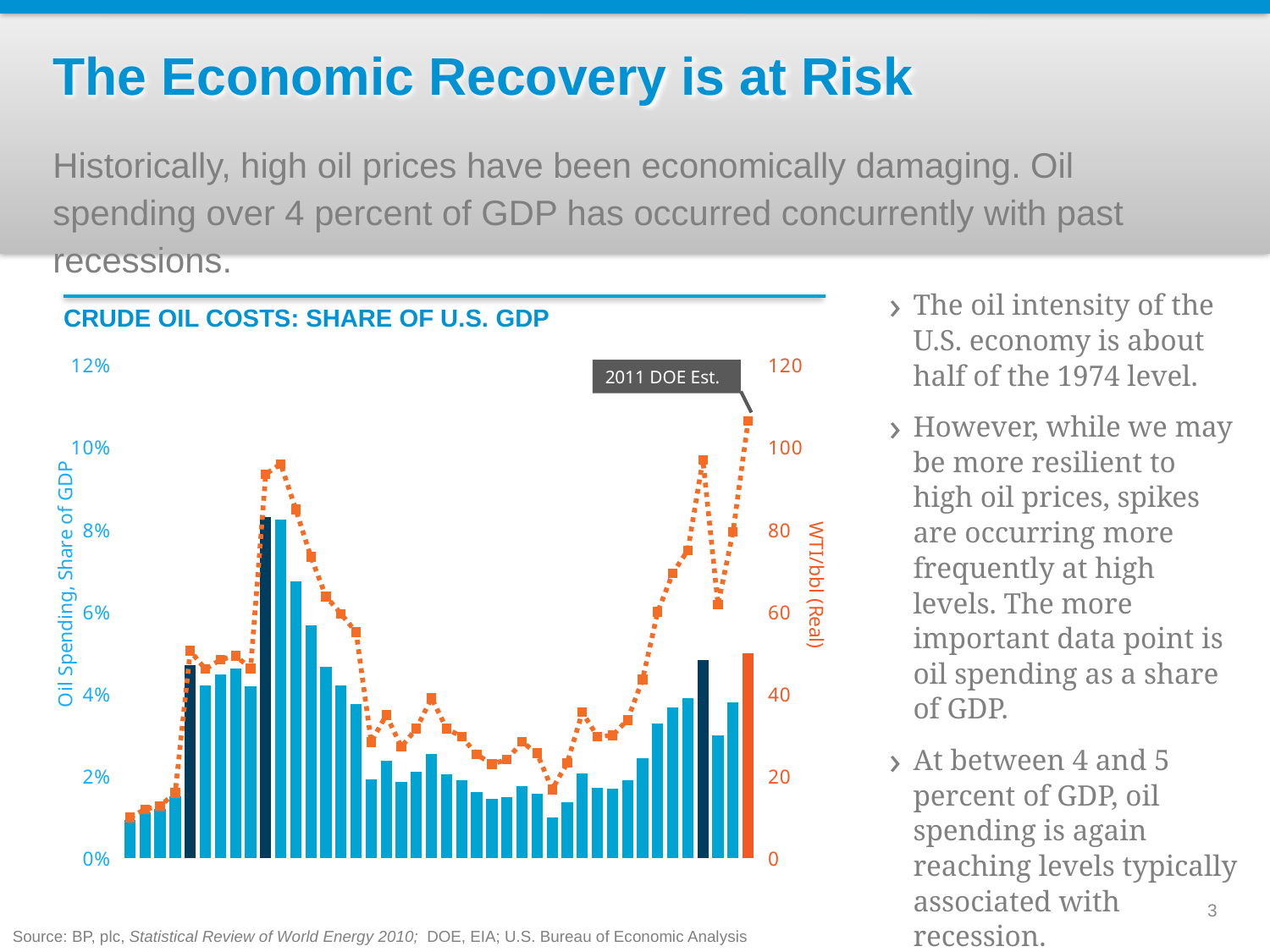
What text does the callout box near the end of the orange line say? 2011 DOE Est. What kind of chart is used to show oil spending as a share of GDP? Bar chart What is the highest value shown on the right axis of the chart? 120 What label is shown on the right vertical axis of the chart? WTI/bbl (Real) Is the oil spending share of GDP for the first bar on the left greater or less than 2%? less Is the WTI/bbl value at the 2011 DOE Est. point greater or less than 100? greater Is the peak of the WTI/bbl line in the left half of the chart greater or less than 80? greater